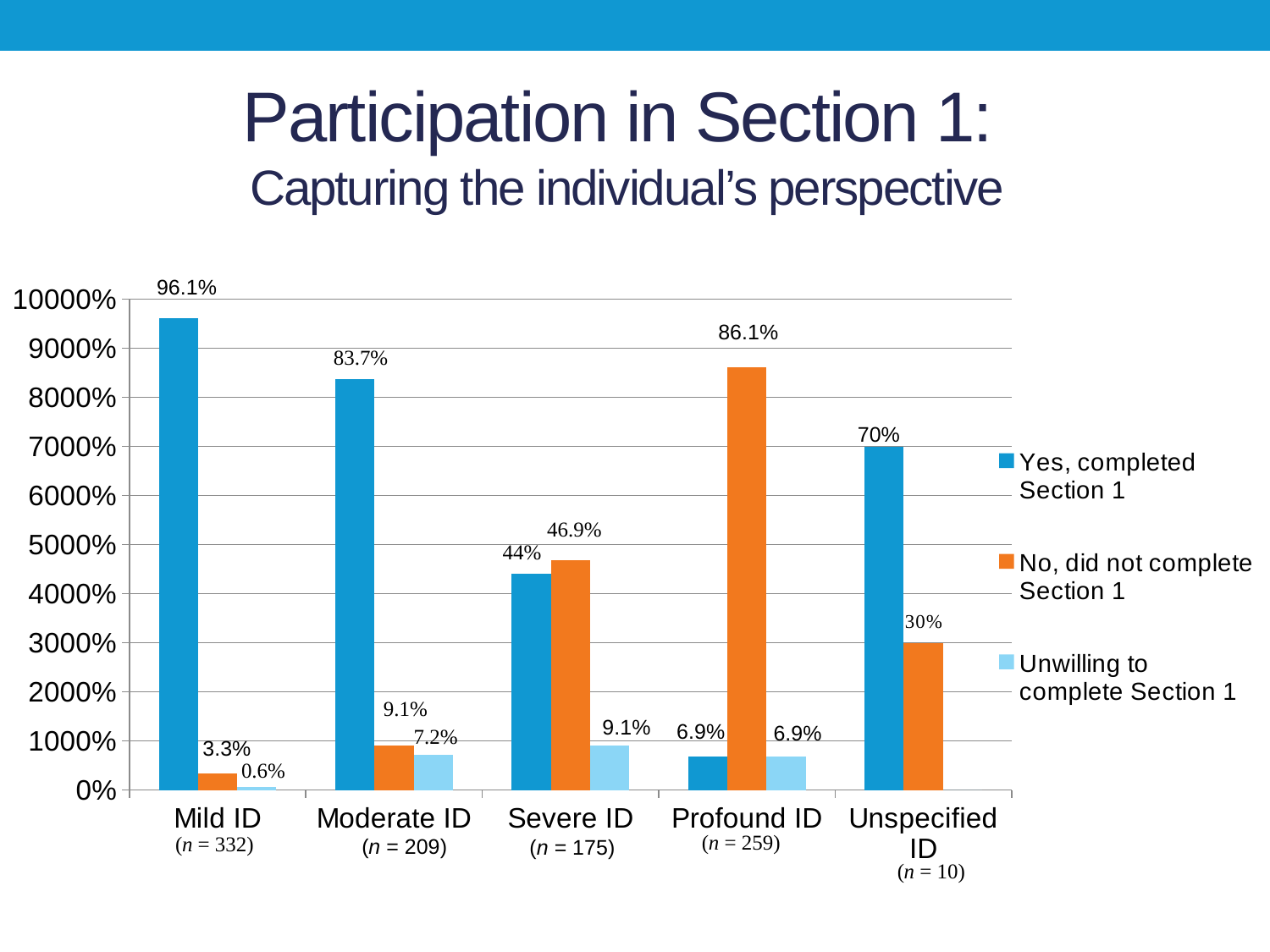
How many ID categories are shown on the x axis? 5 For Severe ID, which is larger: 'Yes, completed Section 1' or 'No, did not complete Section 1'? No, did not complete Section 1 Which category has the lowest value for 'Yes, completed Section 1'? Profound ID Which category has the highest value for 'Yes, completed Section 1'? Mild ID What is the value for 'Unwilling to complete Section 1' for Moderate ID? 7.2% What is the value for 'Yes, completed Section 1' for Mild ID? 96.1% What is the difference between the 'Yes, completed Section 1' values for Mild ID and Moderate ID? 12.4% How many series does the legend list? 3 What kind of chart is shown on the slide? Bar chart What is the sample size (n) shown for Profound ID? 259 What is the value for 'No, did not complete Section 1' for Profound ID? 86.1% What is the value for 'No, did not complete Section 1' for Unspecified ID? 30%